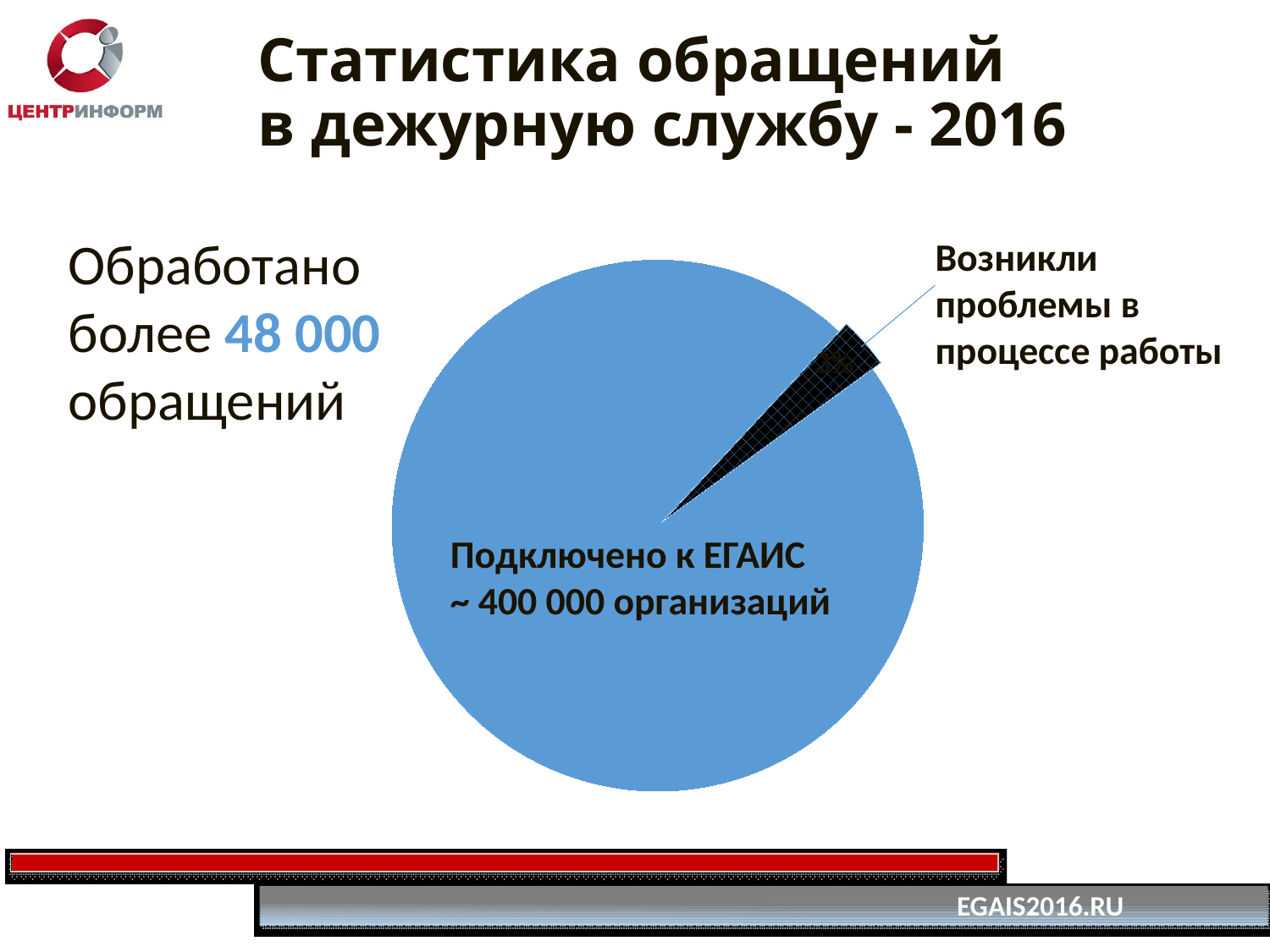
Which slice of the pie chart is the largest? Подключено к ЕГАИС What colour is the large slice of the pie chart? blue Which slice is larger: "Подключено к ЕГАИС" or "Возникли проблемы в процессе работы"? Подключено к ЕГАИС What is the title of the slide containing the pie chart? Статистика обращений в дежурную службу - 2016 Which slice of the pie chart is the smallest? Возникли проблемы в процессе работы How many slices does the pie chart have? 2 What kind of chart is shown on the slide? pie chart